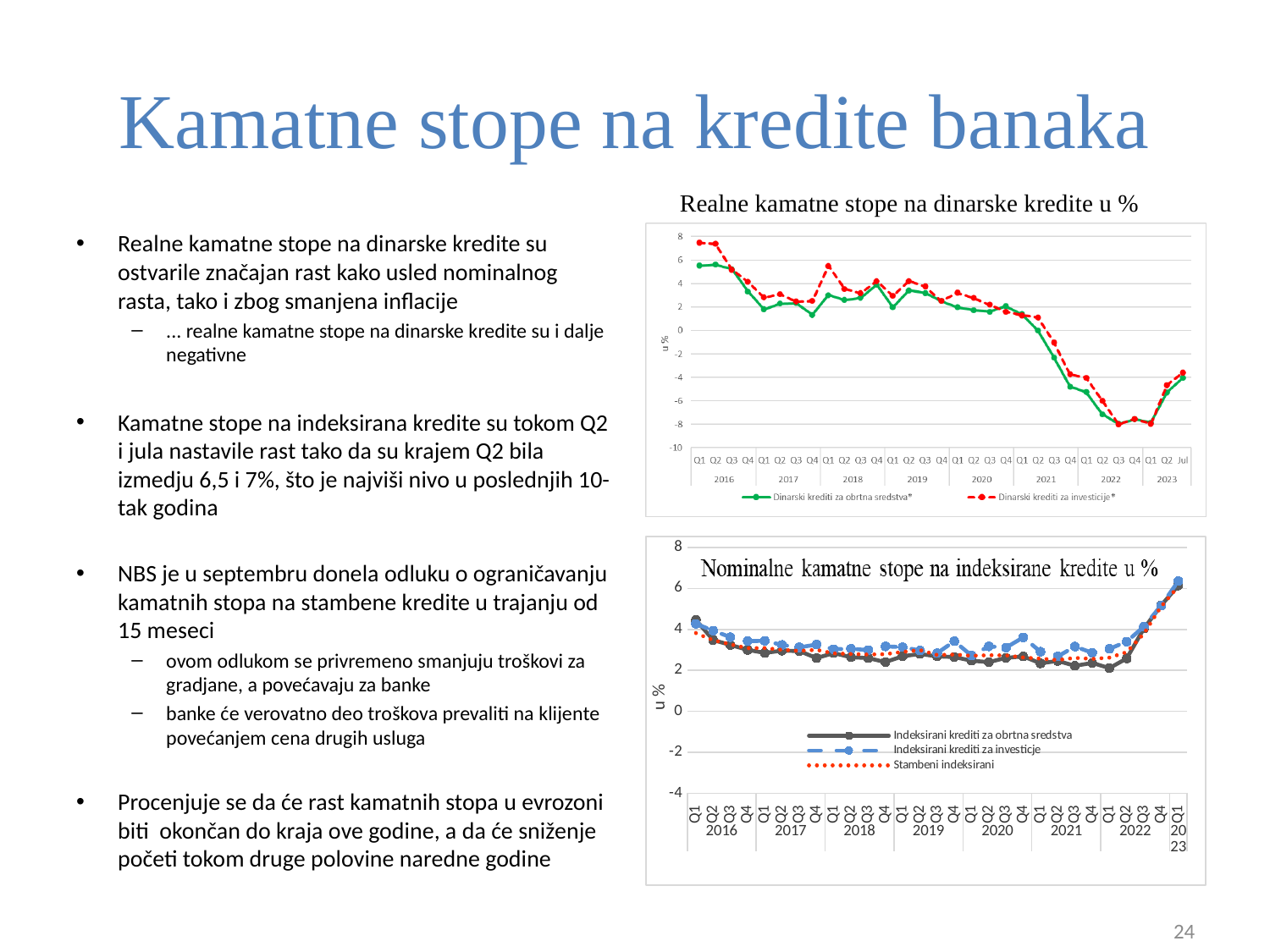
What type of chart is the top chart titled "Realne kamatne stope na dinarske kredite u %"? line chart In the bottom chart (Nominalne kamatne stope na indeksirane kredite u %), is the value for Indeksirani krediti za investicije in Q1 2023 greater or less than 4? greater In the top chart (Realne kamatne stope na dinarske kredite u %), is the value for Dinarski krediti za obrtna sredstva in Q3 2022 greater or less than -6? less How many series does the legend of the bottom chart (Nominalne kamatne stope na indeksirane kredite u %) list? 3 What type of chart is the bottom chart titled "Nominalne kamatne stope na indeksirane kredite u %"? line chart In the top chart (Realne kamatne stope na dinarske kredite u %), do the values for Dinarski krediti za investicije rise or fall from Q1 2016 to Q3 2022? fall In the top chart (Realne kamatne stope na dinarske kredite u %), which series has the higher value in Q1 2016: Dinarski krediti za obrtna sredstva or Dinarski krediti za investicije? Dinarski krediti za investicije In the bottom chart (Nominalne kamatne stope na indeksirane kredite u %), is the value for Stambeni indeksirani in Q1 2021 greater or less than 0? greater How many series does the legend of the top chart (Realne kamatne stope na dinarske kredite u %) list? 2 In the bottom chart (Nominalne kamatne stope na indeksirane kredite u %), do the values rise or fall from Q2 2022 to Q1 2023? rise What is the title of the bottom chart on the slide? Nominalne kamatne stope na indeksirane kredite u %